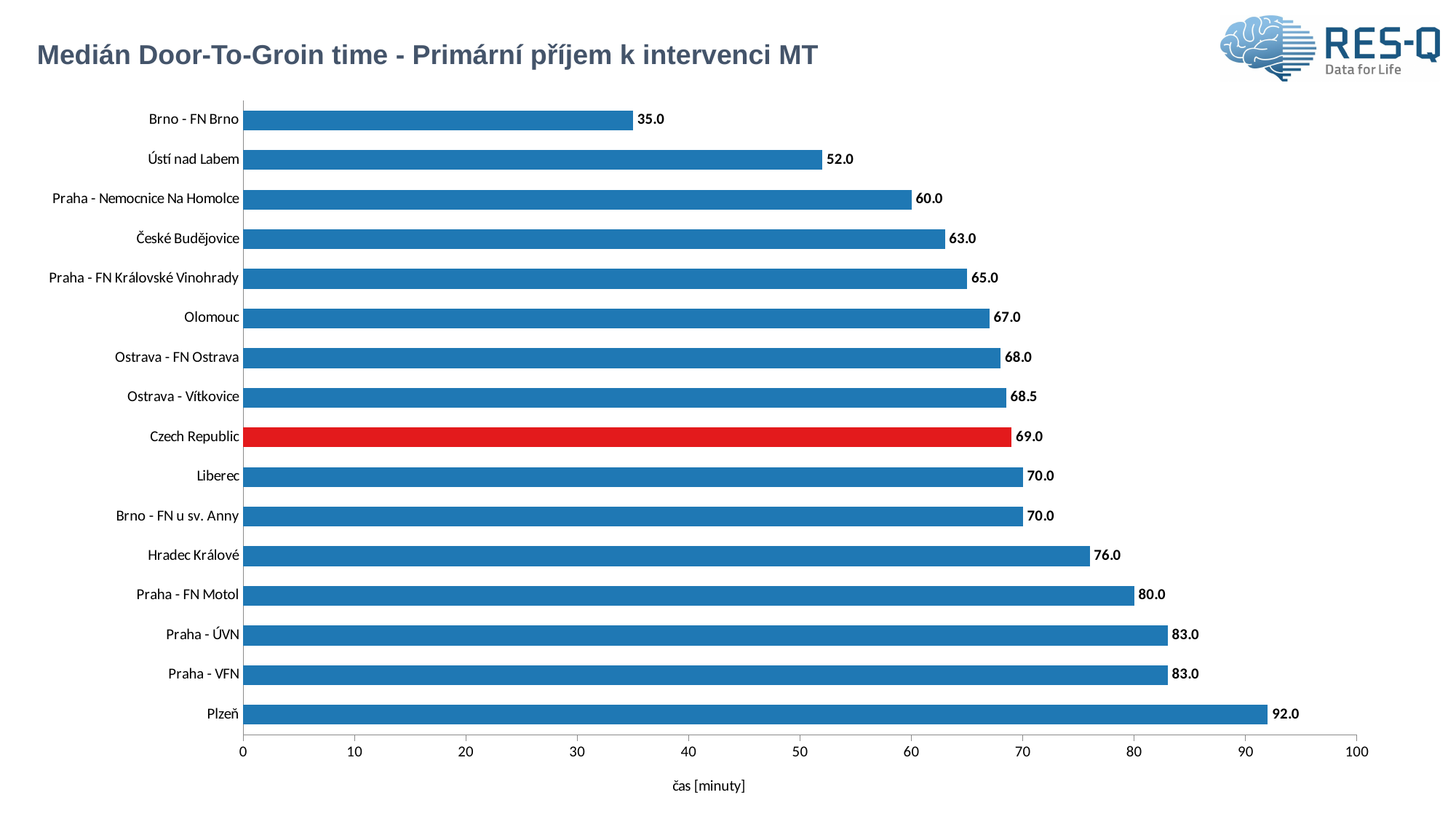
How many categories are shown on the chart? 16 What is the value shown for Hradec Králové? 76.0 What is the value shown for Czech Republic? 69.0 What is the difference between the values for Praha - FN Motol and Czech Republic? 11.0 Is the value for Praha - ÚVN greater or less than 80? greater What is the difference between the values for Plzeň and Brno - FN Brno? 57.0 Which is larger, the value for Ústí nad Labem or the value for Olomouc? Olomouc What kind of chart is shown on the slide? bar chart What is the median Door-To-Groin time for Brno - FN Brno? 35.0 Which category has the highest median Door-To-Groin time? Plzeň Which category has the lowest median Door-To-Groin time? Brno - FN Brno Which bar is coloured red instead of blue? Czech Republic